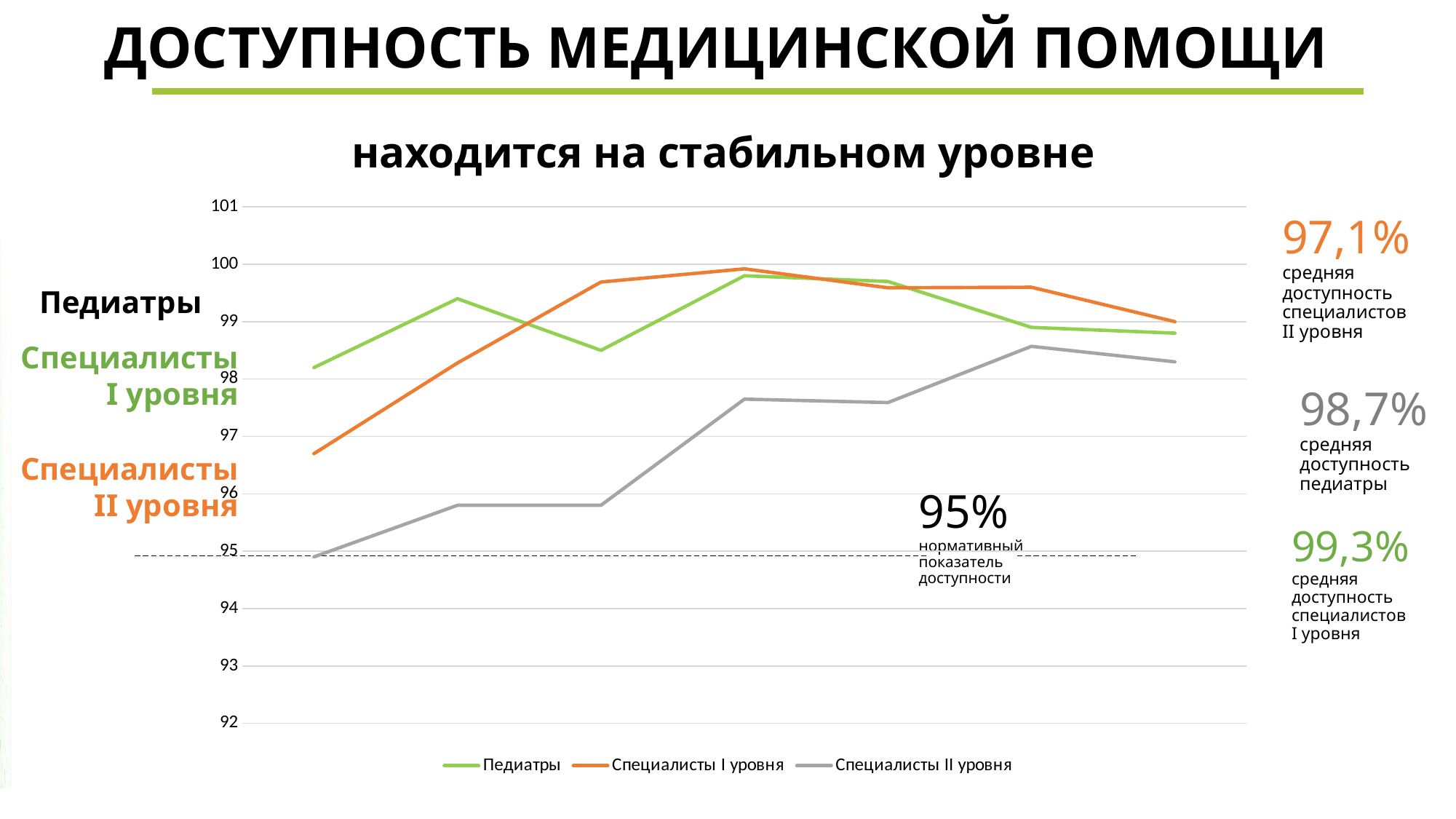
Is the first value of the Специалисты II уровня line greater or less than 96? less How many series does the chart legend list? 3 Does the Специалисты II уровня line generally rise or fall from left to right? rise What kind of chart is shown on the slide? line chart How many data points does each line in the chart have? 7 At the first point, which is higher: Педиатры or Специалисты I уровня? Педиатры What colour is the Специалисты I уровня line in the chart? orange Is the first value of the Специалисты I уровня line greater or less than 97? less Is the last value of the Педиатры line greater or less than 98? greater What average accessibility is given for Специалисты I уровня on the slide? 99,3% What normative accessibility indicator is marked by the dashed line on the chart? 95% Which series in the chart stays lowest across all points? Специалисты II уровня